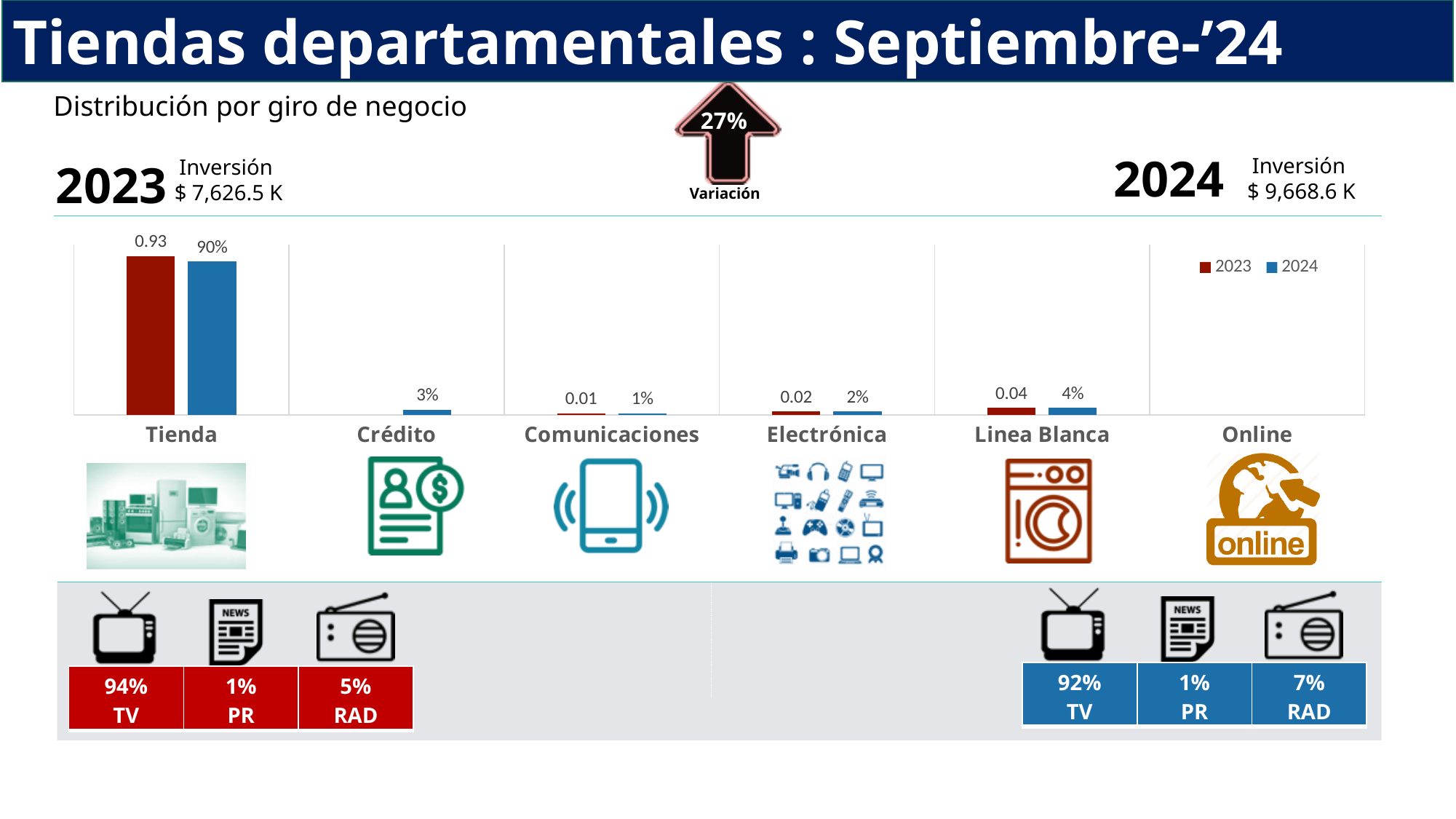
What is the 2024 value for Crédito? 3% How many series does the chart legend list? 2 What is the 2024 value for Comunicaciones? 1% What is the 2024 value for Tienda? 90% What kind of chart is shown on the slide? Bar chart Which category has the highest 2024 value? Tienda Which of Linea Blanca or Electrónica has the larger 2024 value? Linea Blanca How many categories are shown on the x axis of the chart? 6 What is the difference between the 2024 values for Linea Blanca and Crédito? 1% What is the 2023 value for Electrónica? 0.02 What is the 2024 value for Linea Blanca? 4% What is the 2023 value for Tienda? 0.93